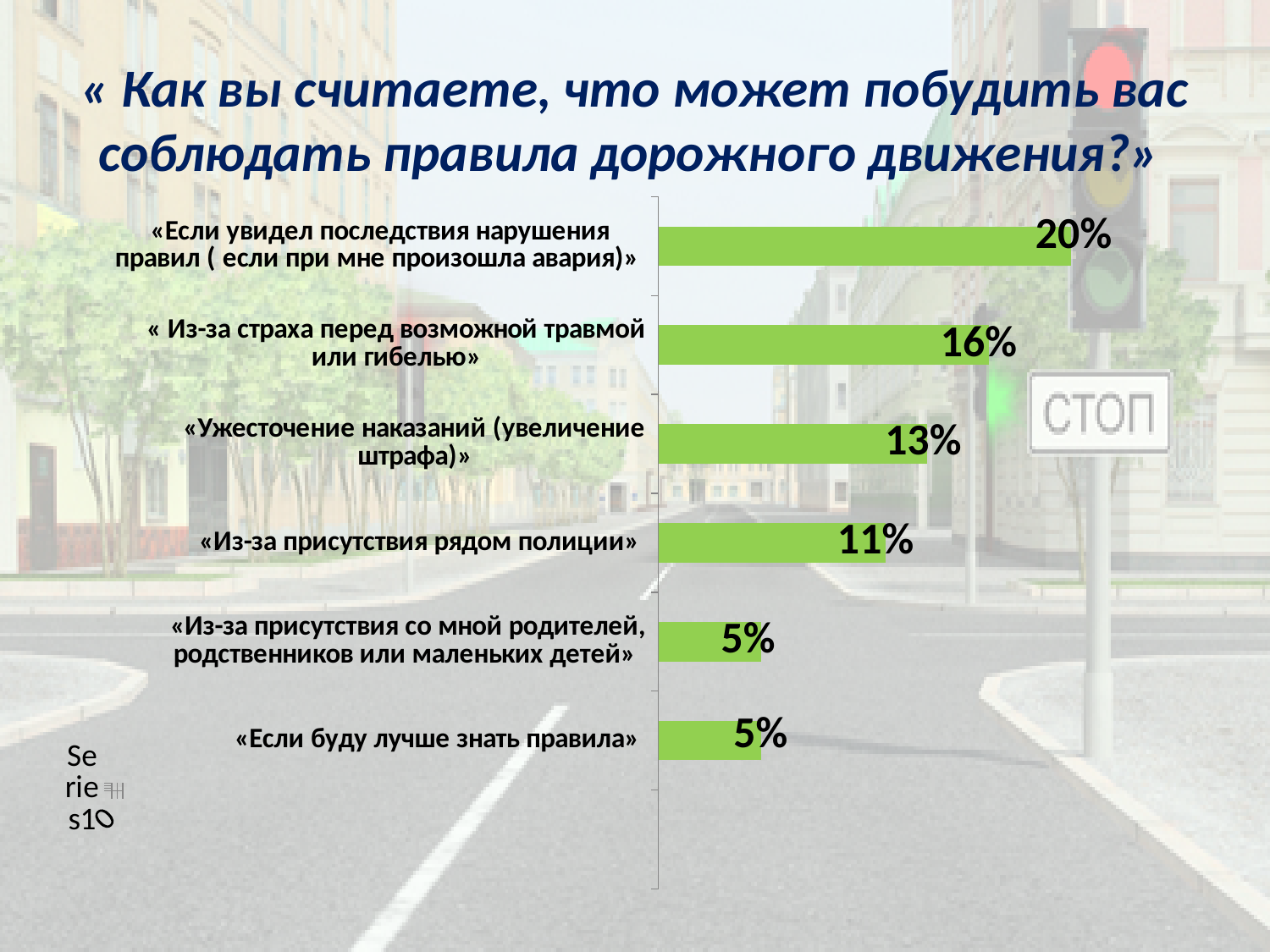
What colour are the bars in the chart? green What is the value for « Из-за страха перед возможной травмой или гибелью»? 16% What type of chart is shown on the slide? bar chart Which is larger: the value for «Ужесточение наказаний (увеличение штрафа)» or the value for «Из-за присутствия рядом полиции»? «Ужесточение наказаний (увеличение штрафа)» What is the difference between the values for «Если увидел последствия нарушения правил ( если при мне произошла авария)» and « Из-за страха перед возможной травмой или гибелью»? 4% What is the value for «Ужесточение наказаний (увеличение штрафа)»? 13% What is the difference between the values for «Из-за присутствия рядом полиции» and «Из-за присутствия со мной родителей, родственников или маленьких детей»? 6% What is the value for «Если буду лучше знать правила»? 5% How many categories (answer options) are plotted in the chart? 6 Which category has the highest value? «Если увидел последствия нарушения правил ( если при мне произошла авария)» What is the value for «Если увидел последствия нарушения правил ( если при мне произошла авария)»? 20% What is the value for «Из-за присутствия рядом полиции»? 11%